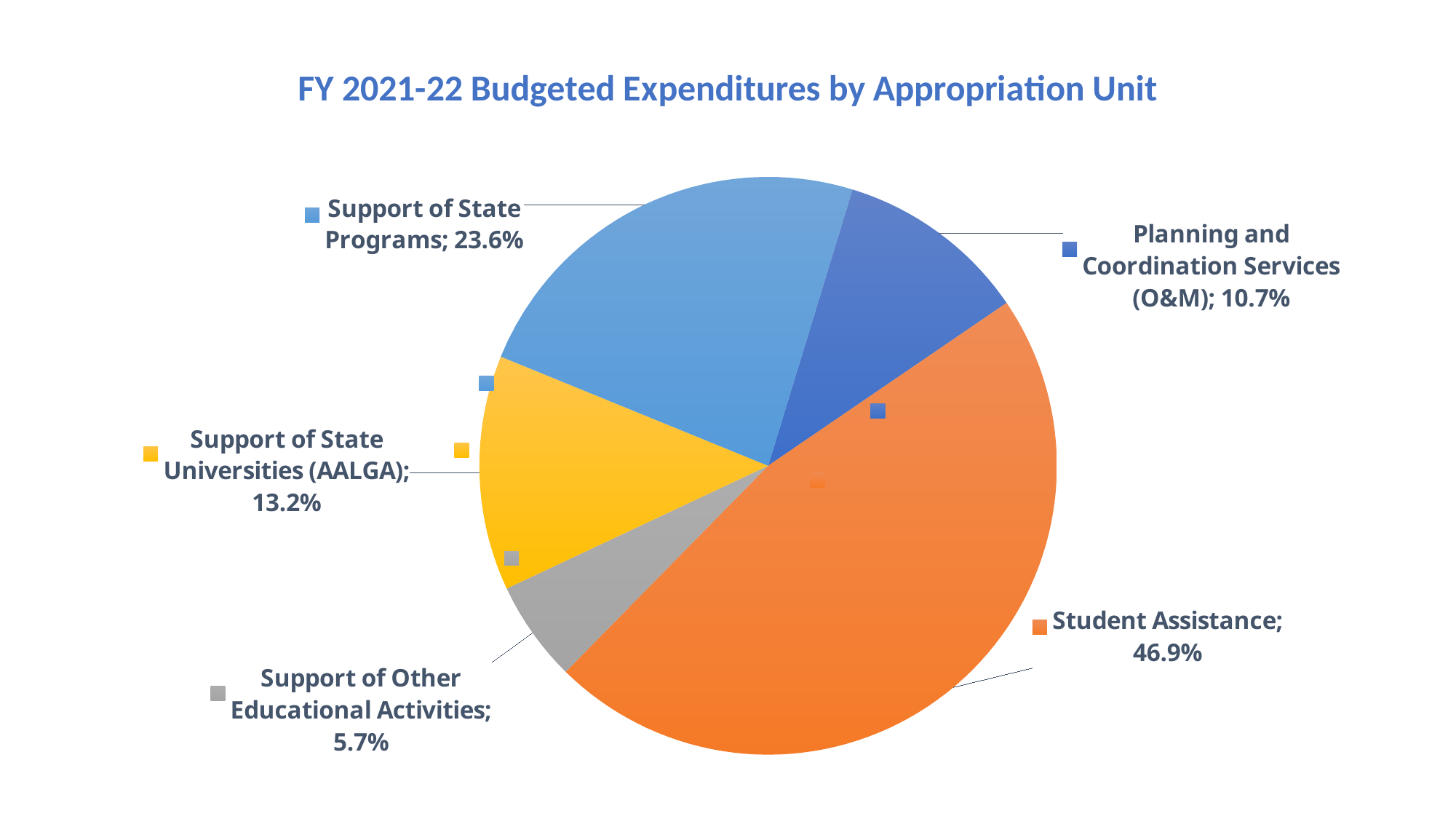
What share of FY 2021-22 budgeted expenditures goes to Student Assistance? 46.9% What percentage is shown for Support of State Programs? 23.6% What is the difference in percentage points between Student Assistance and Support of State Programs? 23.3 What kind of chart is shown on the slide? Pie chart How many appropriation units are shown in the pie chart? 5 Which appropriation unit has the largest share of budgeted expenditures? Student Assistance What percentage is shown for Support of Other Educational Activities? 5.7% What is the title of the chart? FY 2021-22 Budgeted Expenditures by Appropriation Unit Which appropriation unit has the smallest share of budgeted expenditures? Support of Other Educational Activities Which is larger, the share for Support of State Universities (AALGA) or for Planning and Coordination Services (O&M)? Support of State Universities (AALGA) What percentage is shown for Support of State Universities (AALGA)? 13.2% What percentage is shown for Planning and Coordination Services (O&M)? 10.7%